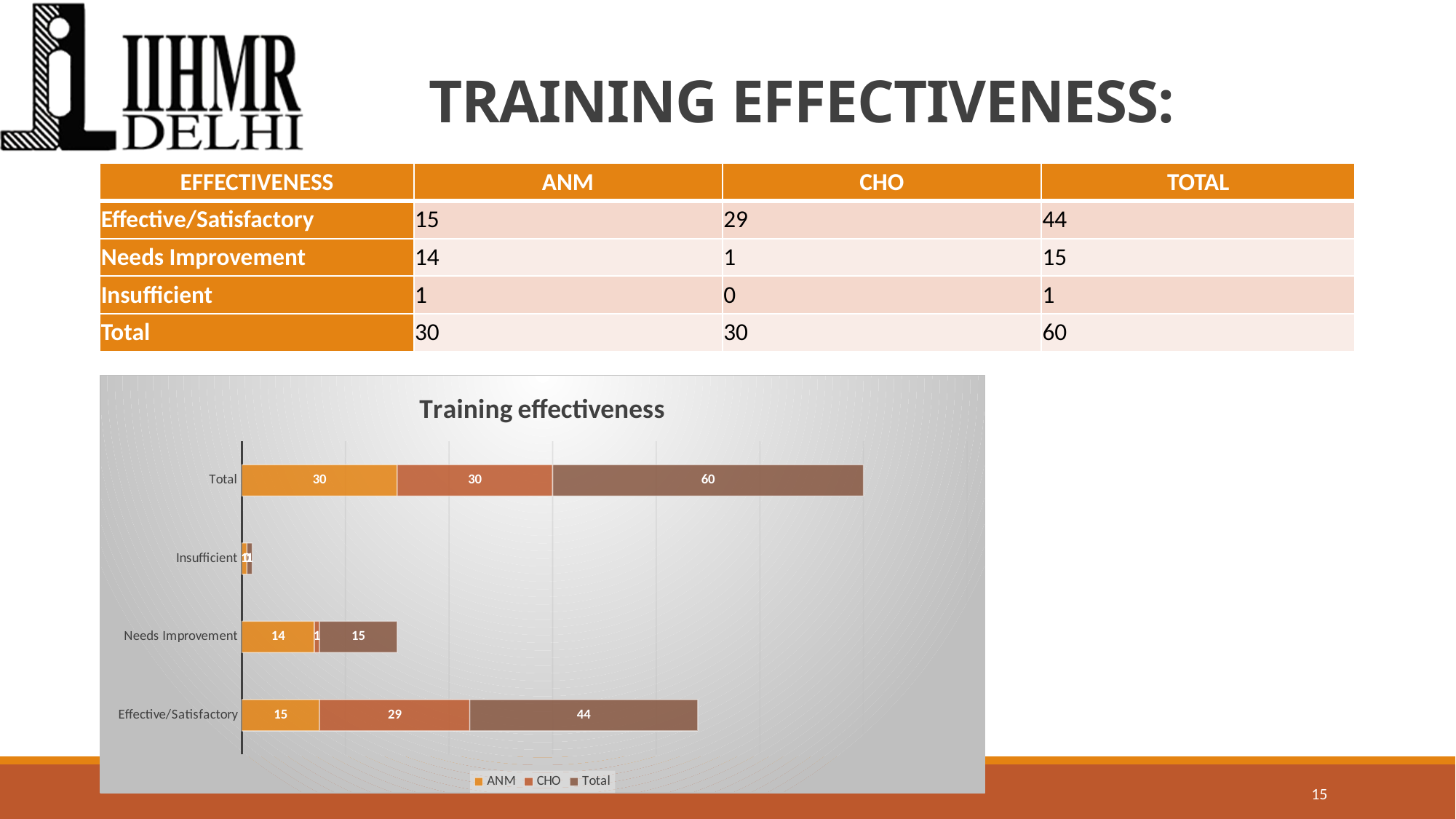
Which category has the longest stacked bar in the chart? Total What is the ANM value for Effective/Satisfactory in the chart? 15 How many series does the chart legend list? 3 What is the Total series value for the Total category in the chart? 60 What is the CHO value for Effective/Satisfactory in the chart? 29 For Needs Improvement, which is larger: the ANM value or the CHO value? ANM What is the CHO value for Needs Improvement in the chart? 1 Which category has the shortest stacked bar in the chart? Insufficient What is the difference between the CHO value and the ANM value for Effective/Satisfactory? 14 What kind of chart is shown on the slide? Stacked bar chart What is the title of the chart? Training effectiveness How many categories are shown on the chart's vertical axis? 4